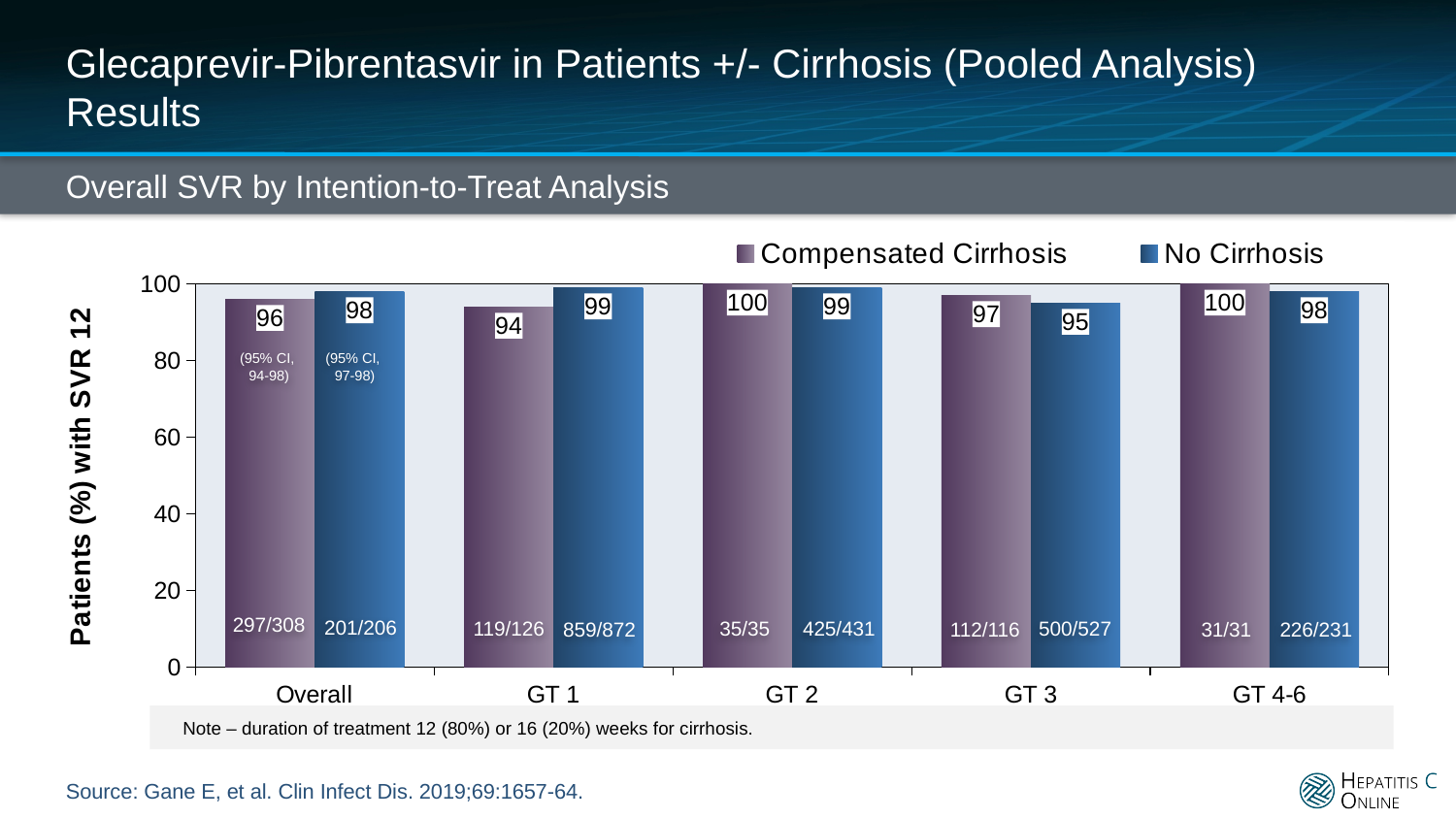
What is the SVR 12 rate for Compensated Cirrhosis patients in the Overall group? 96 What is the y-axis label of the chart? Patients (%) with SVR 12 What is the SVR 12 rate for No Cirrhosis patients in GT 1? 99 What kind of chart is shown on the slide? Bar chart Which genotype group has the lowest SVR 12 rate for No Cirrhosis patients? GT 3 What is the SVR 12 rate for Compensated Cirrhosis patients in GT 3? 97 What is the difference between the No Cirrhosis and Compensated Cirrhosis SVR 12 rates in GT 1? 5 Which genotype group has the lowest SVR 12 rate for Compensated Cirrhosis patients? GT 1 In GT 3, which group has the higher SVR 12 rate, Compensated Cirrhosis or No Cirrhosis? Compensated Cirrhosis How many genotype categories are shown on the x axis? 5 How many series does the legend list? 2 What is the 95% CI shown for the Overall No Cirrhosis group? 97-98